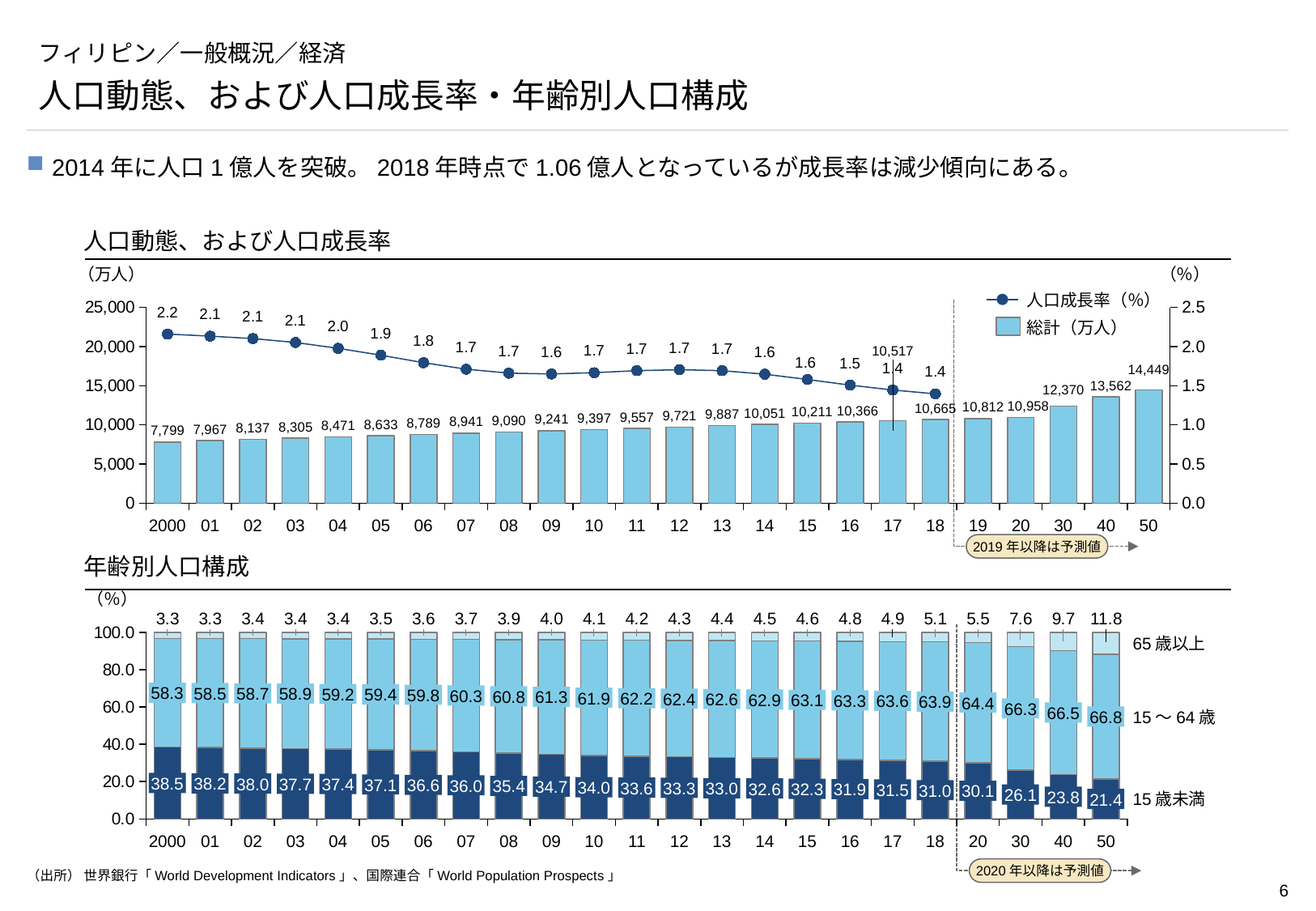
In the top chart (人口動態、および人口成長率), which year has the highest 総計 bar? 50 In the bottom chart (年齢別人口構成), what is the 65歳以上 value for 50? 11.8 In the top chart (人口動態、および人口成長率), what is the 総計 value for 2014? 10,051 What kind of chart is the bottom chart (年齢別人口構成)? stacked bar chart In the top chart (人口動態、および人口成長率), what is the 人口成長率 value for 2000? 2.2 In the top chart (人口動態、および人口成長率), what does the note next to the dashed vertical line say? 2019年以降は予測値 In the bottom chart (年齢別人口構成), what is the difference between the 15歳未満 values for 2000 and 50? 17.1 In the bottom chart (年齢別人口構成), what is the 15歳未満 value for 18? 31.0 In the top chart (人口動態、および人口成長率), does the 人口成長率 line generally rise or fall from 2000 to 18? fall In the top chart (人口動態、および人口成長率), what is the difference between the 総計 values for 50 and 2000? 6,650 How many series does the legend of the top chart (人口動態、および人口成長率) list? 2 In the bottom chart (年齢別人口構成), is the 15～64歳 value larger for 2000 or for 50? 50